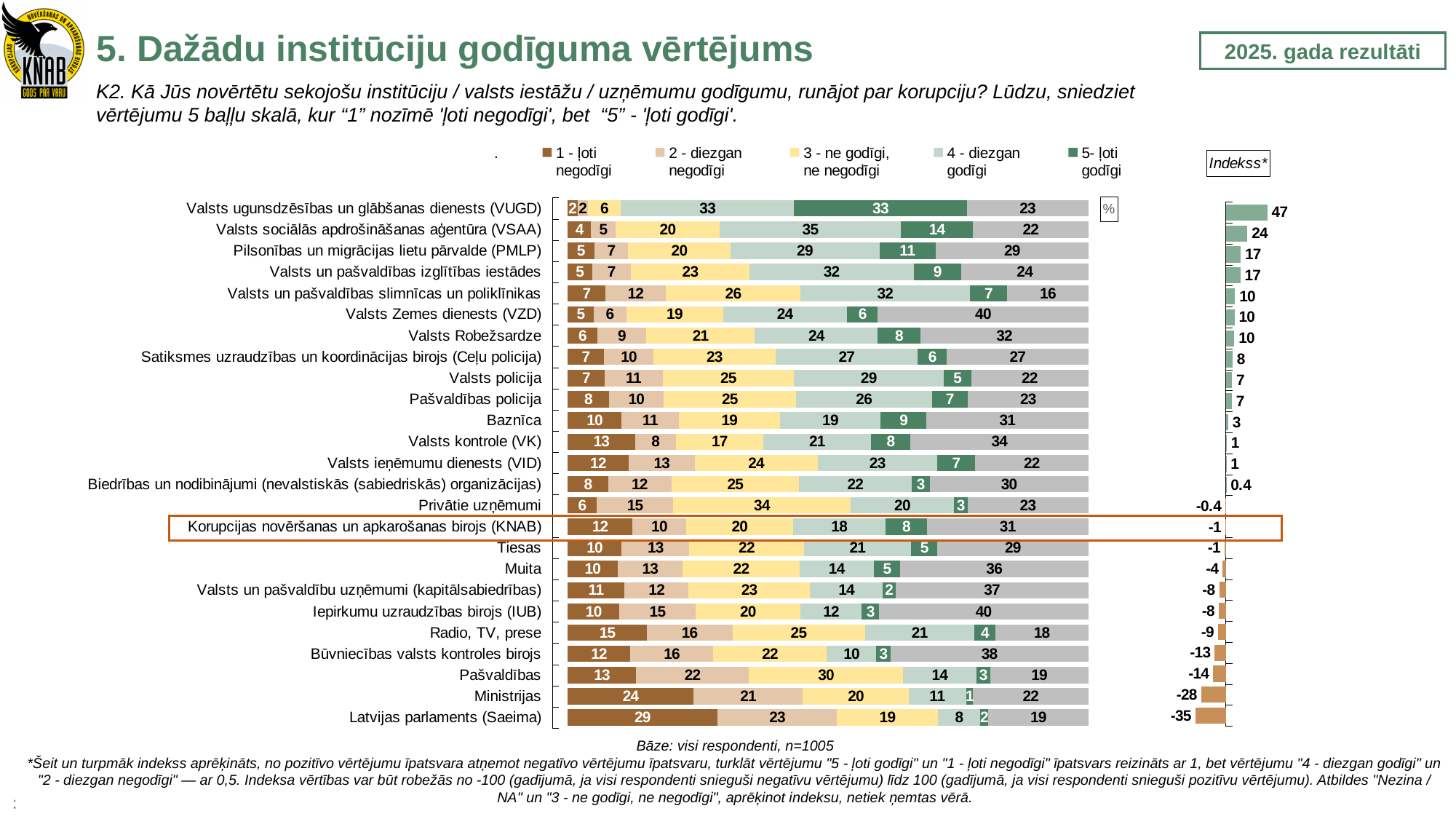
What type of chart is used to show the institution ratings? Bar chart Which institution has the highest index (Indekss*) value? Valsts ugunsdzēsības un glābšanas dienests (VUGD) What is the index (Indekss*) value for Korupcijas novēršanas un apkarošanas birojs (KNAB)? -1 What is the difference between the index values of Valsts ugunsdzēsības un glābšanas dienests (VUGD) and Valsts sociālās apdrošināšanas aģentūra (VSAA)? 23 How many rating categories does the legend of the stacked bar chart list? 5 What is the base (number of respondents) stated below the chart? n=1005 How many institutions are listed in the stacked bar chart? 25 Which has a larger share of '1 - ļoti negodīgi' ratings: Ministrijas or Latvijas parlaments (Saeima)? Latvijas parlaments (Saeima) In the stacked bar chart, what percentage of respondents rated Latvijas parlaments (Saeima) as '1 - ļoti negodīgi'? 29 In the stacked bar chart, what percentage of respondents rated Valsts ugunsdzēsības un glābšanas dienests (VUGD) as '5 - ļoti godīgi'? 33 Which institution has the lowest index (Indekss*) value? Latvijas parlaments (Saeima) What is the index (Indekss*) value for Ministrijas? -28